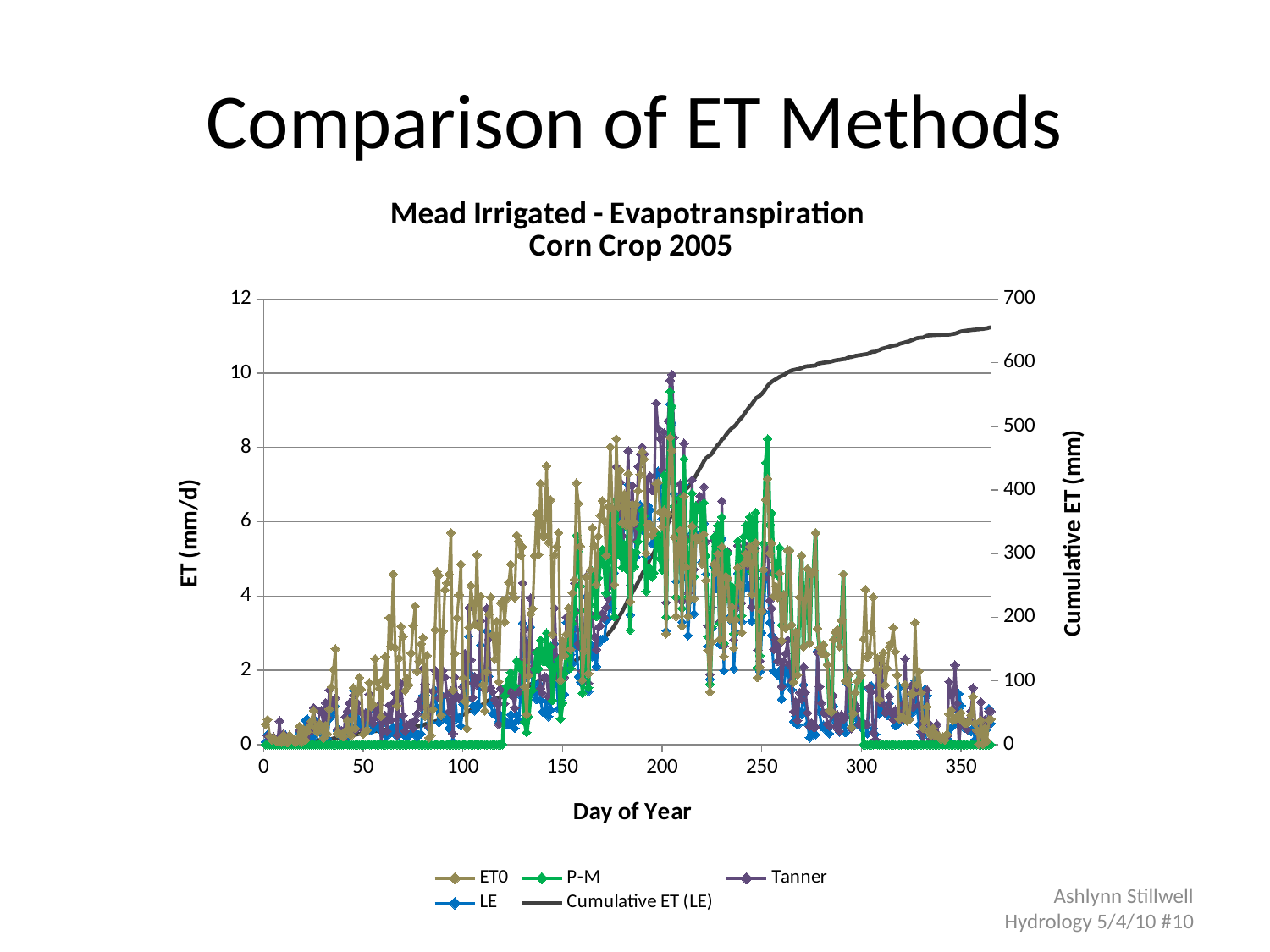
Is the highest Tanner value greater or less than 8? greater What is the title of the chart? Mead Irrigated - Evapotranspiration Corn Crop 2005 Is the highest ET0 value greater or less than 10? less Does the Cumulative ET (LE) series rise or fall as Day of Year increases? rise Is the Cumulative ET (LE) value at day 200 greater or less than 500? less What kind of chart is shown on the slide? line chart How many series does the legend list? 5 What is the label of the x axis? Day of Year Which series is plotted against the right-hand axis labelled Cumulative ET (mm)? Cumulative ET (LE)